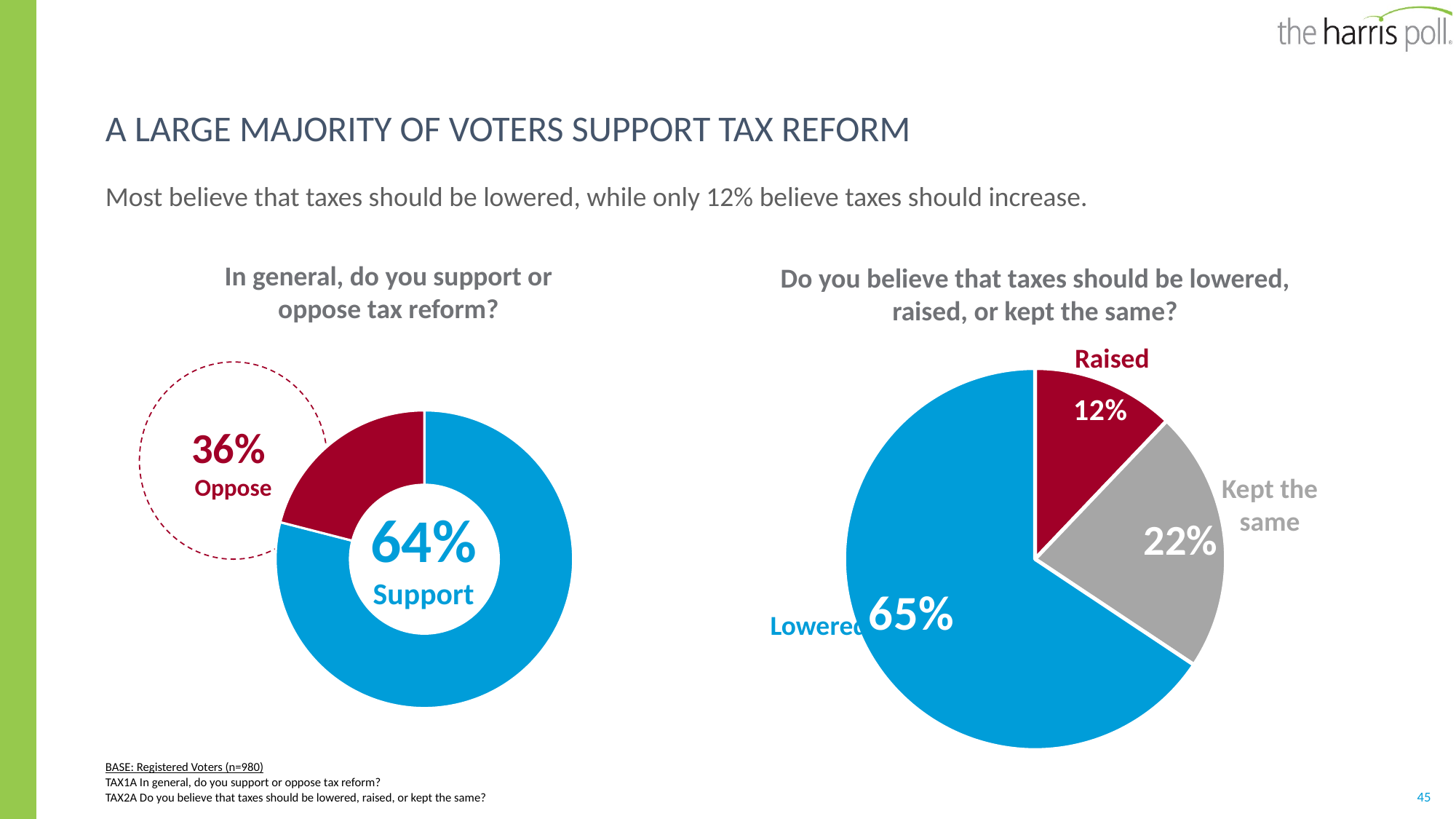
In the right chart 'Do you believe that taxes should be lowered, raised, or kept the same?', what percentage say taxes should be kept the same? 22% In the right chart 'Do you believe that taxes should be lowered, raised, or kept the same?', what percentage say taxes should be lowered? 65% In the right chart 'Do you believe that taxes should be lowered, raised, or kept the same?', how many slices does the pie have? 3 In the left chart 'In general, do you support or oppose tax reform?', what percentage of voters oppose tax reform? 36% In the right chart 'Do you believe that taxes should be lowered, raised, or kept the same?', which category has the largest share? Lowered In the left chart 'In general, do you support or oppose tax reform?', what percentage of voters support tax reform? 64% In the right chart 'Do you believe that taxes should be lowered, raised, or kept the same?', what percentage say taxes should be raised? 12% In the right chart 'Do you believe that taxes should be lowered, raised, or kept the same?', what is the difference between the Kept the same and Raised percentages? 10% What kind of chart is the left chart 'In general, do you support or oppose tax reform?' Doughnut chart In the left chart 'In general, do you support or oppose tax reform?', which is larger, Support or Oppose? Support In the left chart 'In general, do you support or oppose tax reform?', what is the difference between the Support and Oppose percentages? 28% In the right chart 'Do you believe that taxes should be lowered, raised, or kept the same?', which category has the smallest share? Raised